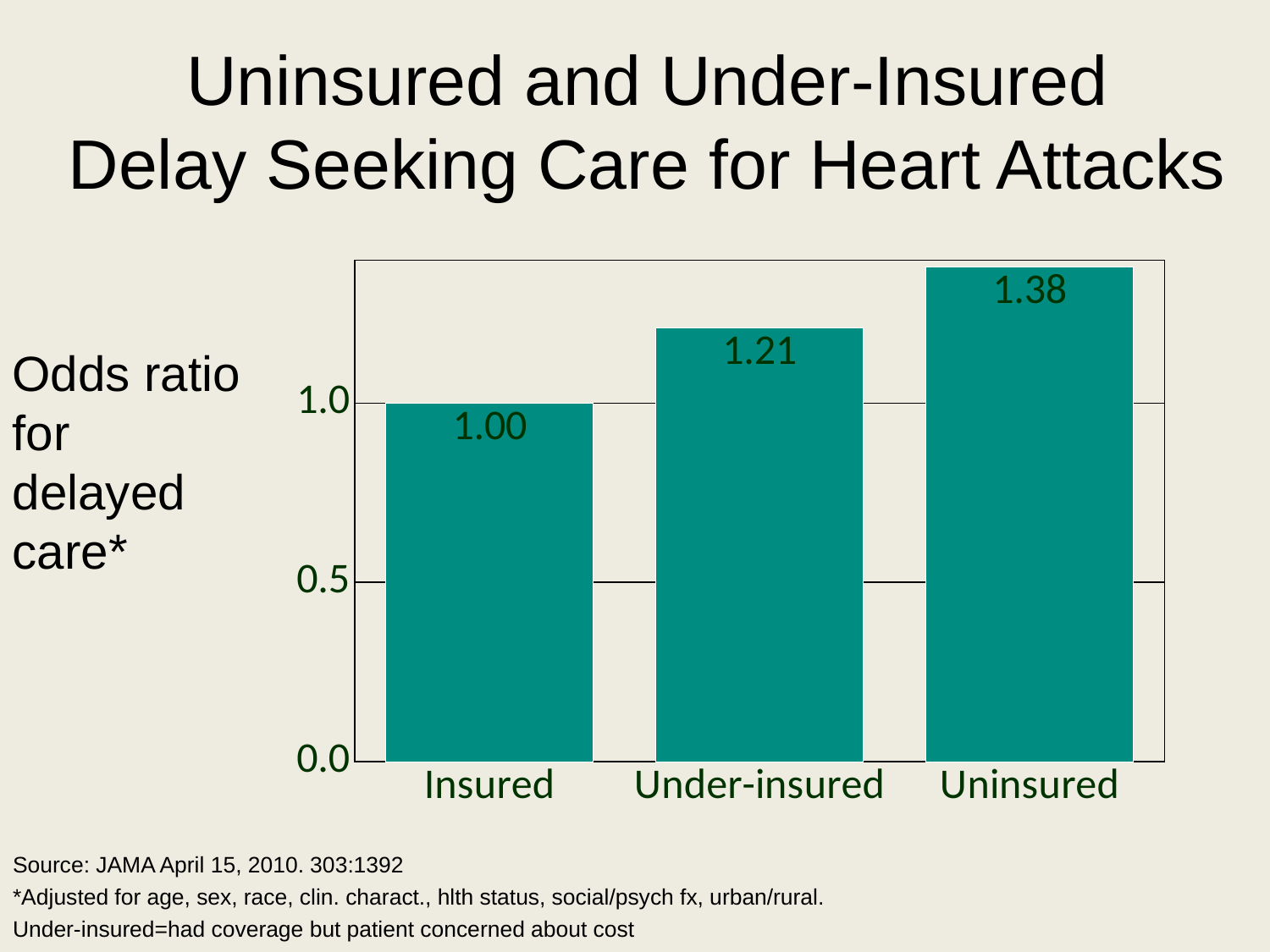
Which group has a larger odds ratio, Under-insured or Insured? Under-insured What kind of chart is shown on the slide? bar chart What is the difference between the odds ratios for the Uninsured and Under-insured groups? 0.17 Is the odds ratio for the Under-insured group greater or less than 1.0? greater Which group has the lowest odds ratio for delayed care? Insured Do the odds ratios rise or fall from Insured to Uninsured along the x axis? rise What is the odds ratio for delayed care for the Uninsured group? 1.38 How many groups are shown on the chart? 3 What is the odds ratio for delayed care for the Insured group? 1.00 What is the odds ratio for delayed care for the Under-insured group? 1.21 What is the difference between the odds ratios for the Uninsured and Insured groups? 0.38 Which group has the highest odds ratio for delayed care? Uninsured